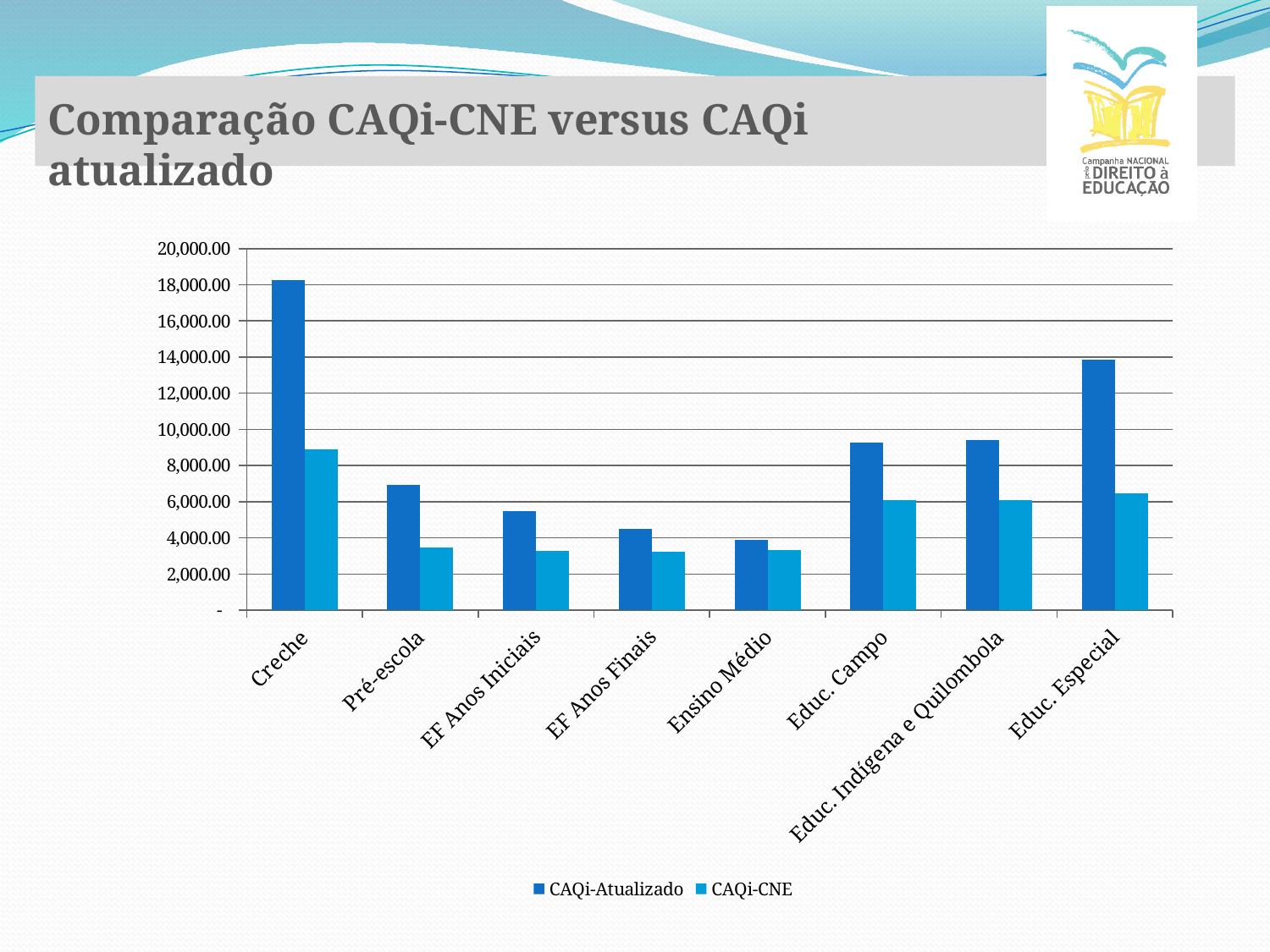
Which category has the highest CAQi-CNE value? Creche Which category has the lowest CAQi-Atualizado value? Ensino Médio Is the CAQi-Atualizado value for Creche greater or less than 16,000.00? greater How many categories are shown on the x axis of the chart? 8 How many series does the chart's legend list? 2 Which category has the highest CAQi-Atualizado value? Creche Is the CAQi-Atualizado value for Educ. Especial greater or less than 12,000.00? greater Is the CAQi-CNE value for Creche greater or less than 8,000.00? greater What are the two series named in the chart's legend? CAQi-Atualizado and CAQi-CNE Which is larger: the CAQi-Atualizado value for Creche or the CAQi-Atualizado value for Educ. Especial? Creche What type of chart is shown on the slide? Bar chart